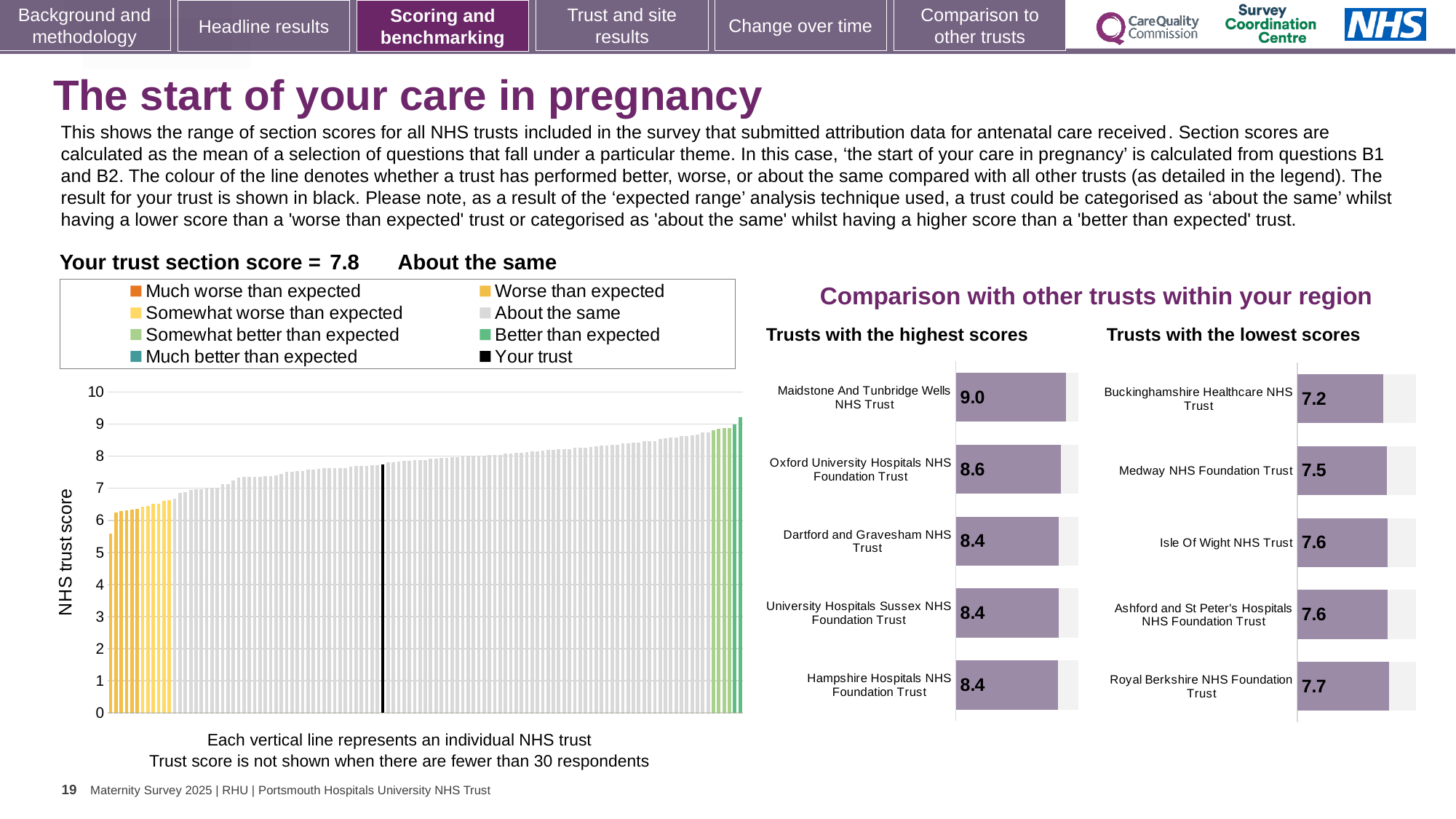
In the 'Trusts with the lowest scores' chart, which trust has the lowest score? Buckinghamshire Healthcare NHS Trust In the 'Trusts with the highest scores' chart, what is the score for Maidstone And Tunbridge Wells NHS Trust? 9.0 What kind of chart is the 'Trusts with the lowest scores' chart? bar chart In the 'Trusts with the highest scores' chart, which trust has the highest score? Maidstone And Tunbridge Wells NHS Trust In the 'Trusts with the lowest scores' chart, which has the larger score: Medway NHS Foundation Trust or Isle Of Wight NHS Trust? Isle Of Wight NHS Trust In the 'Trusts with the lowest scores' chart, what is the score for Medway NHS Foundation Trust? 7.5 How many entries does the legend above the NHS trust score chart list? 8 In the NHS trust score chart on the left, do the trust scores rise or fall from left to right? rise In the 'Trusts with the lowest scores' chart, what is the difference between the scores of Royal Berkshire NHS Foundation Trust and Buckinghamshire Healthcare NHS Trust? 0.5 In the 'Trusts with the highest scores' chart, how many trusts are shown? 5 In the NHS trust score chart on the left, is the value for the black 'Your trust' bar greater or less than 8? less In the 'Trusts with the highest scores' chart, what is the difference between the scores of Maidstone And Tunbridge Wells NHS Trust and Oxford University Hospitals NHS Foundation Trust? 0.4